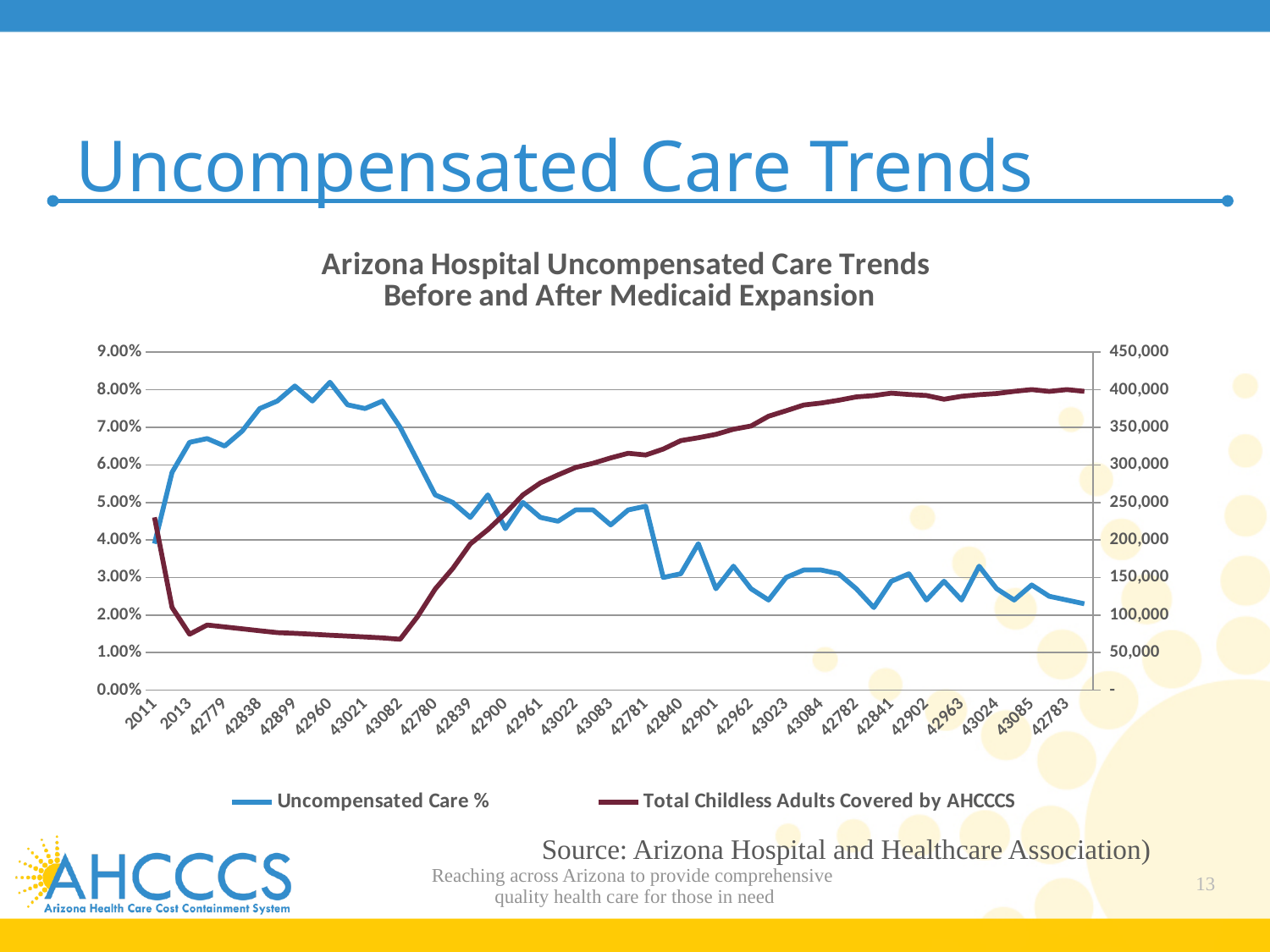
Which series is plotted in blue? Uncompensated Care % Is the Total Childless Adults Covered by AHCCCS value higher at the 2011 label or at the last point on the chart? the last point What kind of chart is shown on the slide? line chart Is the Uncompensated Care % higher at the 2011 label or at the last point on the chart? 2011 Over the full period, does the Total Childless Adults Covered by AHCCCS line generally rise or fall? rise What is the title of the chart? Arizona Hospital Uncompensated Care Trends Before and After Medicaid Expansion Is the Uncompensated Care % value at the 2013 label greater or less than 6.00%? greater After reaching its peak, does the Uncompensated Care % line generally rise or fall toward the right end of the chart? fall Is the Uncompensated Care % value at the last point on the chart greater or less than 3.00%? less Is the Total Childless Adults Covered by AHCCCS value at the last point on the chart greater or less than 350,000? greater How many series does the chart legend list? 2